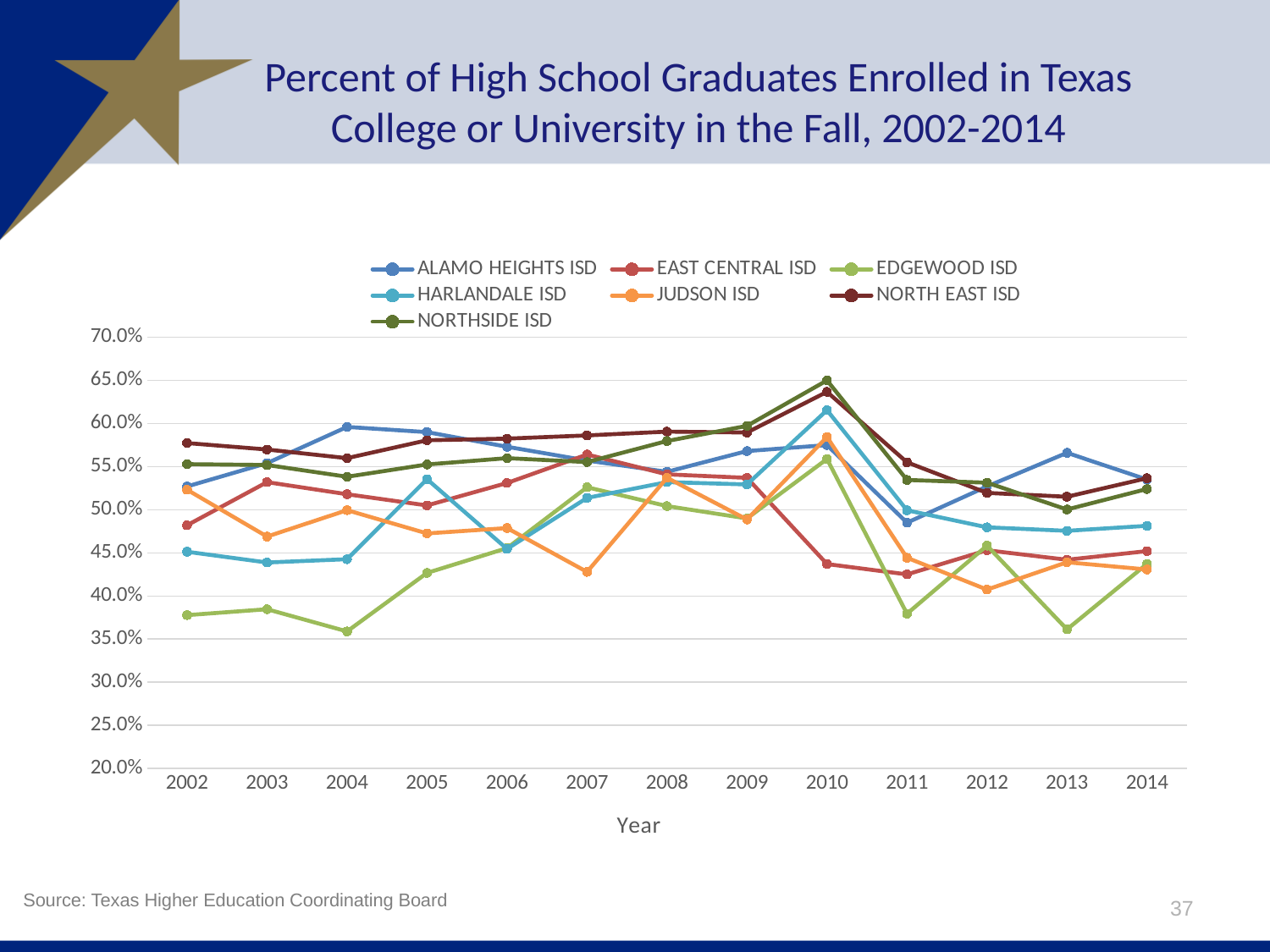
In 2002, which is larger: the value for Harlandale ISD or the value for Edgewood ISD? Harlandale ISD What is the title of the x axis? Year What kind of chart is shown on the slide? line chart Is the value for East Central ISD in 2010 greater or less than 45.0%? less How many years are plotted along the x axis? 13 Does the value for East Central ISD rise or fall from 2009 to 2011? fall How many series does the legend list? 7 Is the value for Northside ISD in 2010 greater or less than 60.0%? greater Is the value for Edgewood ISD in 2004 greater or less than 40.0%? less Which district had the lowest value in 2004? Edgewood ISD Which district had the highest value in 2010? Northside ISD